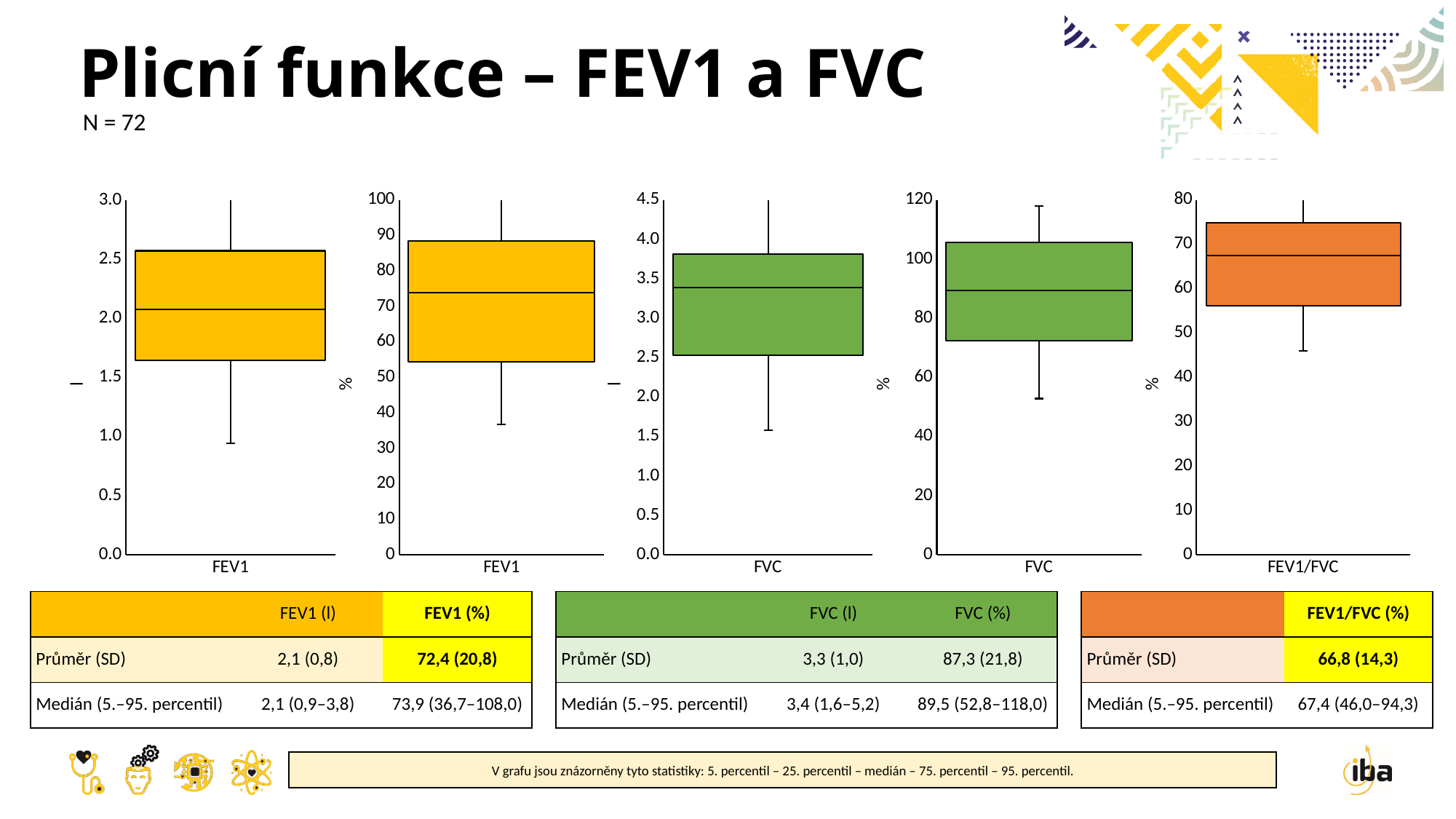
According to the table under the FEV1 charts, what is the median FEV1 in litres? 2,1 In the FVC chart with the litres axis, is the top of the upper whisker greater or less than 4.0? greater What is the sample size N stated on the slide? 72 In the FEV1 chart with the % axis, is the median line greater or less than 80? less What kind of chart is used for the leftmost FEV1 chart? box plot Is the median in the FVC (%) chart higher or lower than the median in the FEV1 (%) chart? higher What colour are the boxes in the two FVC charts? green In the FEV1/FVC chart, is the median line greater or less than 60? greater According to the table under the FEV1/FVC chart, what is the mean (SD) of FEV1/FVC (%)? 66,8 (14,3) How many box plot charts are shown on the slide? 5